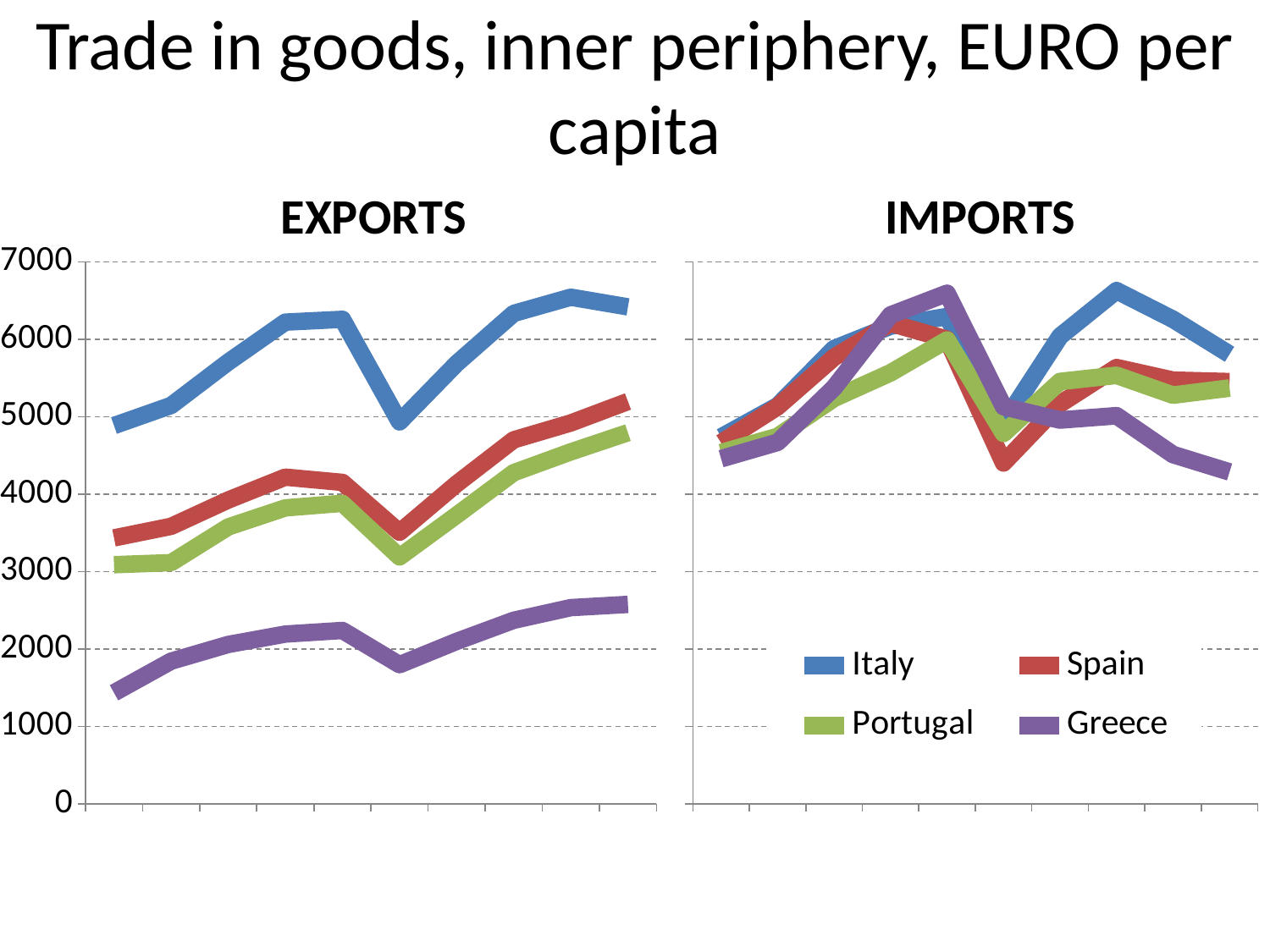
In the EXPORTS chart, which country has the highest line throughout? Italy In the EXPORTS chart, is the first value for Greece greater or less than 2000? less In the IMPORTS chart, is the last value for Greece greater or less than 5000? less In the EXPORTS chart, does the Greece line rise or fall overall from left to right? rise Which countries are listed in the legend? Italy, Spain, Portugal, Greece In the EXPORTS chart, which country has the lowest line throughout? Greece What kind of chart is the EXPORTS chart? line chart In the IMPORTS chart, at the last point, which is larger: Italy or Greece? Italy In the EXPORTS chart, is the first value for Spain greater or less than 4000? less How many data points does each line in the EXPORTS chart have? 10 How many series does the legend list? 4